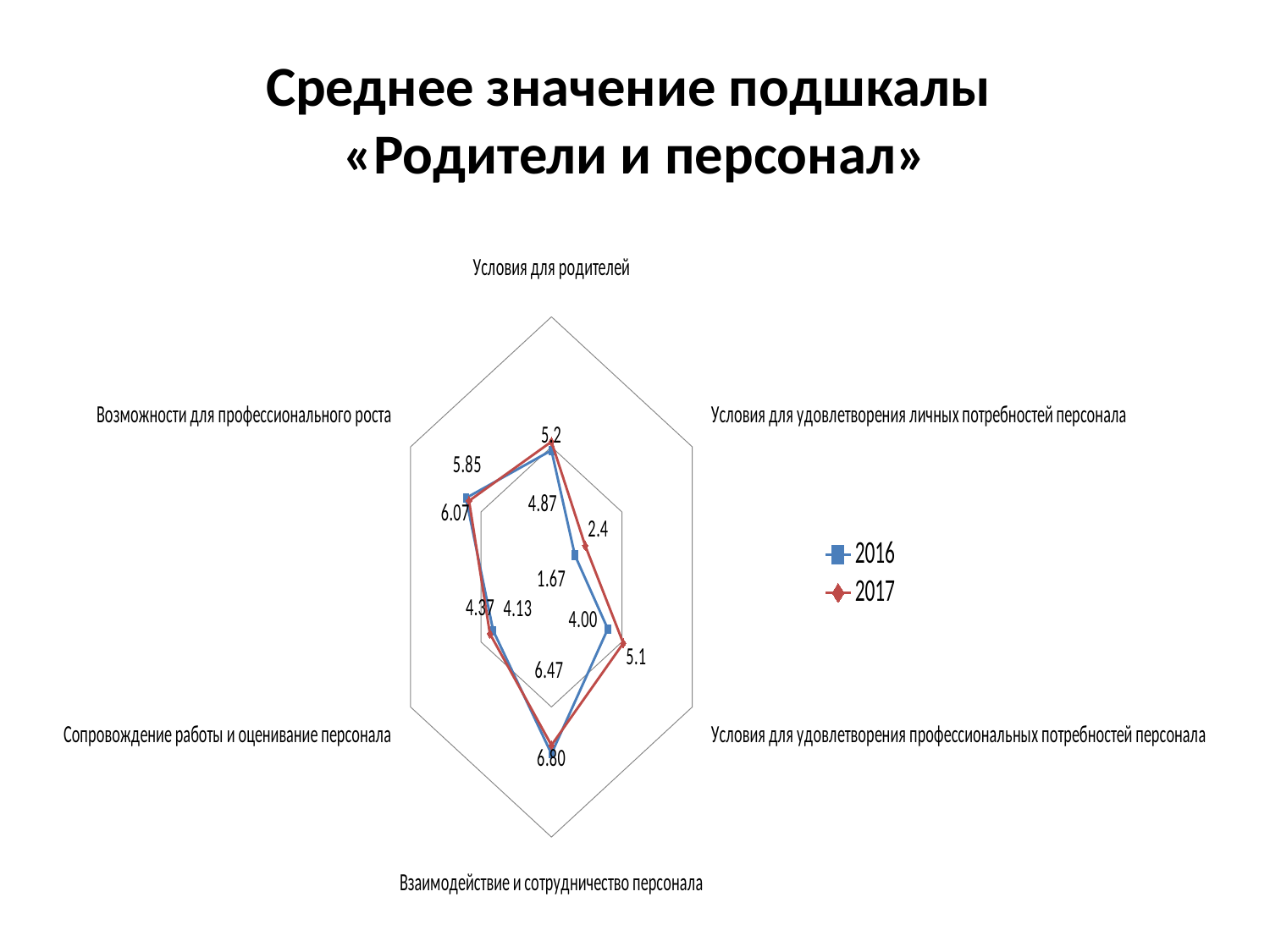
How many categories (axes) does the radar chart have? 6 What is the title of the slide? Среднее значение подшкалы «Родители и персонал» What is the 2017 value for «Условия для удовлетворения профессиональных потребностей персонала»? 5.1 Which category has the highest values for both 2016 and 2017? Взаимодействие и сотрудничество персонала Which category has the lowest values for both 2016 and 2017? Условия для удовлетворения личных потребностей персонала Which years are listed in the legend? 2016 and 2017 What kind of chart is shown on the slide? Radar chart What is the 2016 value for «Условия для удовлетворения личных потребностей персонала»? 1.67 What is the 2017 value for «Условия для удовлетворения личных потребностей персонала»? 2.4 For «Условия для удовлетворения профессиональных потребностей персонала», which year has the larger value, 2016 or 2017? 2017 How many series does the legend list? 2 What is the 2016 value for «Условия для удовлетворения профессиональных потребностей персонала»? 4.00